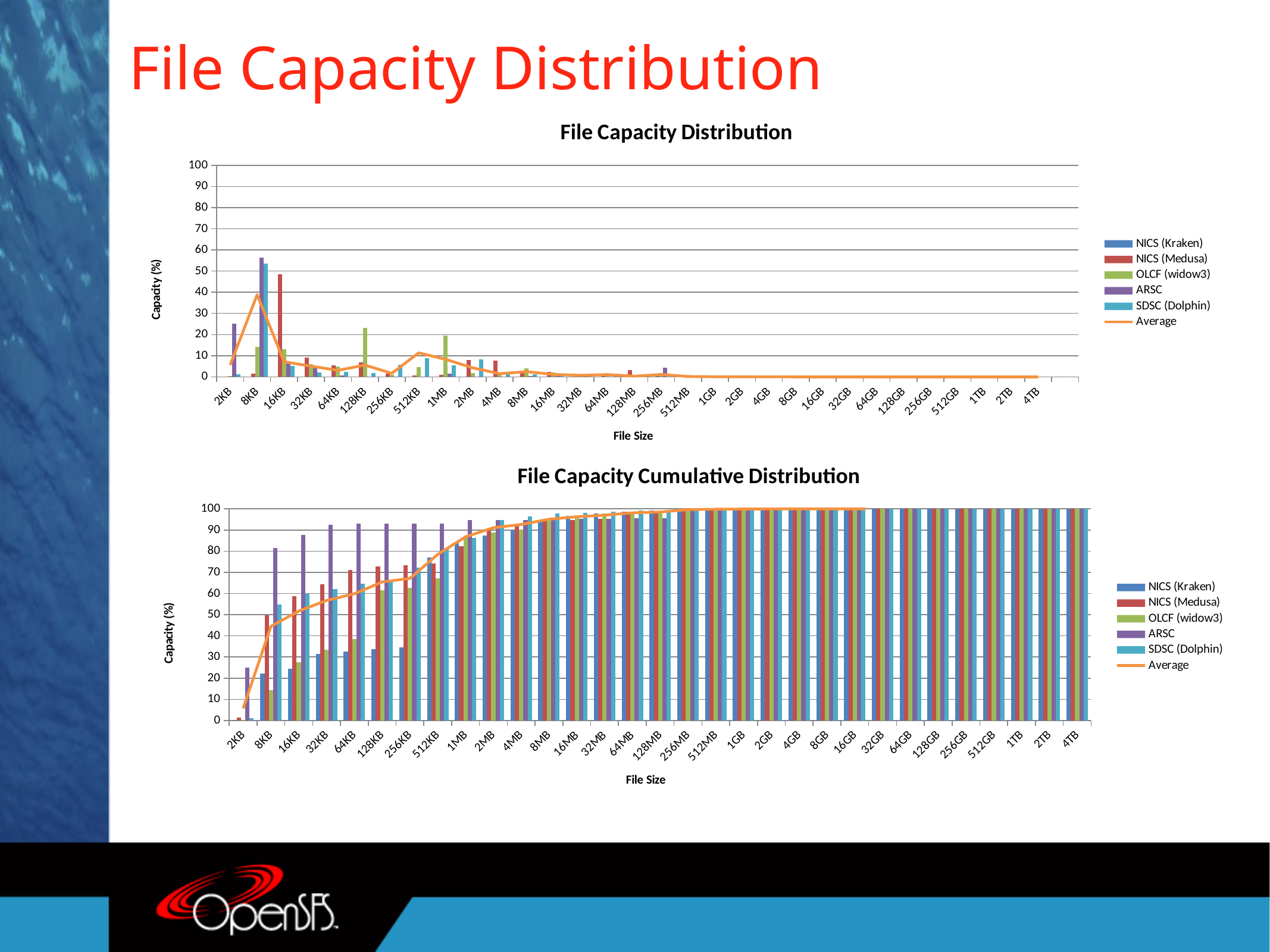
In the bottom chart, File Capacity Cumulative Distribution, is the value for NICS (Kraken) at 2KB greater or less than 10? less In the top chart, File Capacity Distribution, is the value for OLCF (widow3) at 128KB greater or less than 20? greater In the bottom chart, File Capacity Cumulative Distribution, which series has the highest value at 8KB? ARSC In the bottom chart, File Capacity Cumulative Distribution, is the value for ARSC at 8KB greater or less than 70? greater What is the x-axis title of the bottom chart, File Capacity Cumulative Distribution? File Size What kind of chart is the top chart, File Capacity Distribution? combination bar and line chart In the top chart, File Capacity Distribution, which series has the highest value at 16KB? NICS (Medusa) In the bottom chart, File Capacity Cumulative Distribution, does the Average line rise or fall as file size increases? rise In the bottom chart, File Capacity Cumulative Distribution, how many categories are labelled on the x axis? 31 How many series does the legend of the top chart, File Capacity Distribution, list? 6 In the top chart, File Capacity Distribution, which is larger at 128KB: OLCF (widow3) or ARSC? OLCF (widow3)